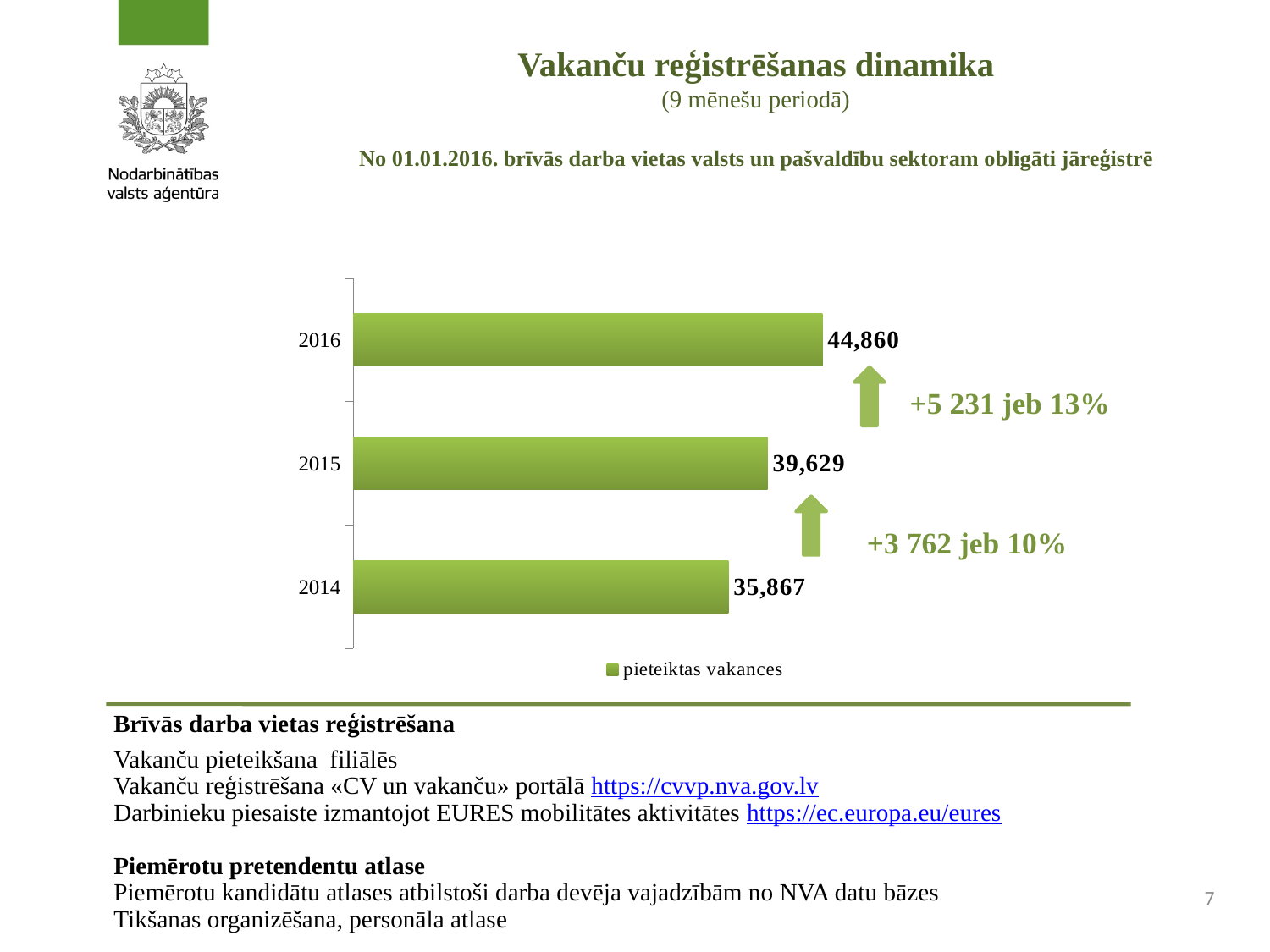
Which year has the lowest value? 2014 What is the difference between the values for 2015 and 2014? 3,762 Which year has the highest value? 2016 What kind of chart is shown? bar chart What is the value for 2015? 39,629 What is the legend entry for the series? pieteiktas vakances What is the difference between the values for 2016 and 2015? 5,231 How many years are shown in the chart? 3 What is the value for 2014? 35,867 What is the value for 2016? 44,860 Which is larger, the value for 2015 or the value for 2014? 2015 How many series does the legend list? 1